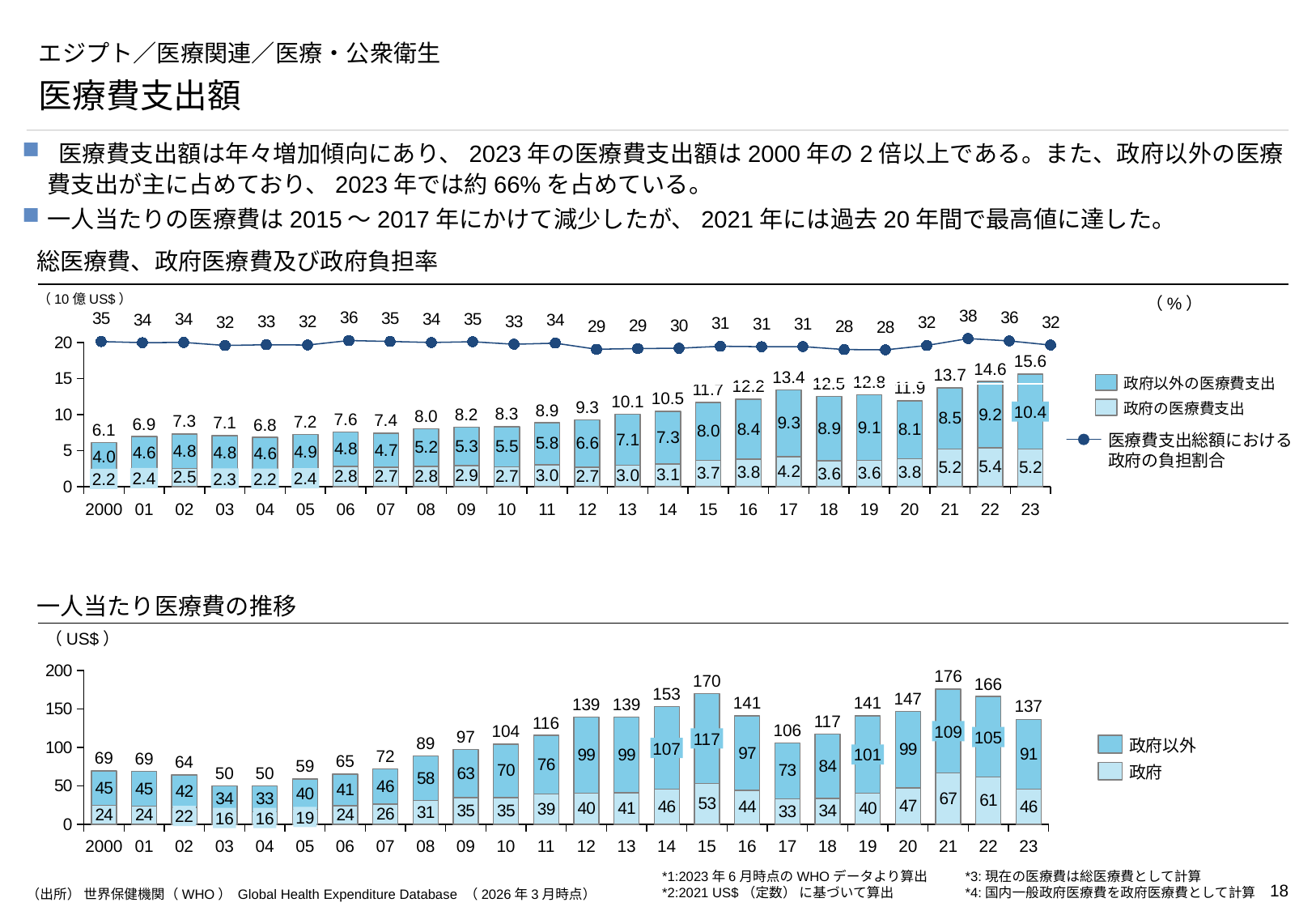
In the chart titled 総医療費、政府医療費及び政府負担率, what is the total health expenditure for 2023? 15.6 In the chart titled 総医療費、政府医療費及び政府負担率, what is the government share (%) shown by the line for 2021? 38 In the chart titled 総医療費、政府医療費及び政府負担率, what is the difference between the 政府以外の医療費支出 values for 2023 and 2000? 6.4 What kind of chart is the chart titled 一人当たり医療費の推移? Stacked bar chart In the chart titled 一人当たり医療費の推移, what is the difference between the totals for 2015 and 2016? 29 In the chart titled 総医療費、政府医療費及び政府負担率, which year has the lowest total health expenditure? 2000 In the chart titled 一人当たり医療費の推移, which year has the highest total per-capita health expenditure? 2021 In the chart titled 総医療費、政府医療費及び政府負担率, what is the value of 政府の医療費支出 for 2021? 5.2 In the chart titled 総医療費、政府医療費及び政府負担率, how many entries does the legend list? 3 In the chart titled 一人当たり医療費の推移, what is the 政府 value for 2015? 53 In the chart titled 一人当たり医療費の推移, which is larger, the total for 2017 or the total for 2018? 2018 In the chart titled 一人当たり医療費の推移, what is the per-capita health expenditure total for 2021? 176